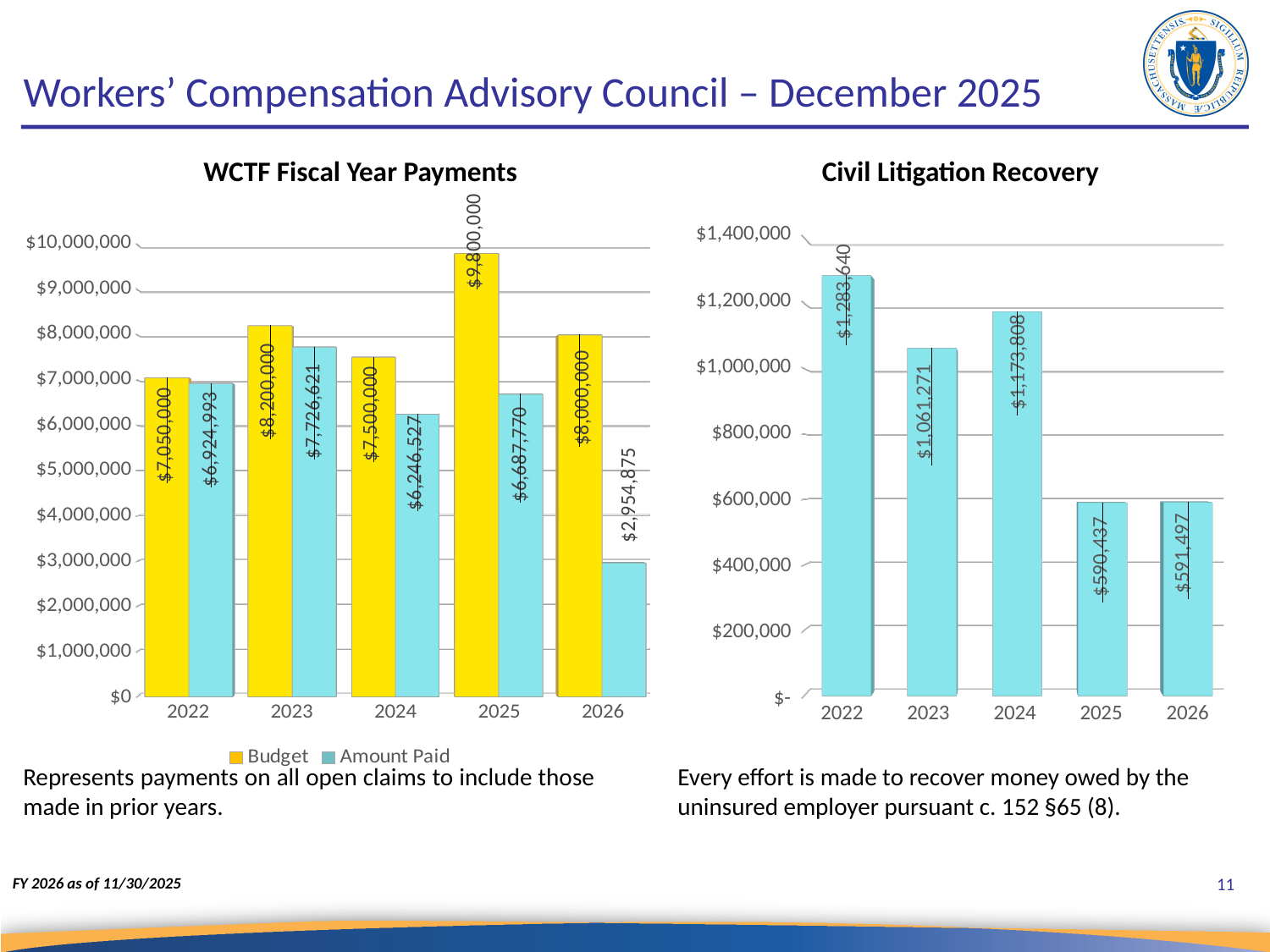
What kind of chart is the Civil Litigation Recovery chart? Bar chart In the WCTF Fiscal Year Payments chart, which year has the lowest Amount Paid? 2026 How many series does the legend of the WCTF Fiscal Year Payments chart list? 2 In the WCTF Fiscal Year Payments chart, which year has the highest Budget? 2025 In the Civil Litigation Recovery chart, which year has the highest value? 2022 In the Civil Litigation Recovery chart, what is the value for 2024? $1,173,808 In the WCTF Fiscal Year Payments chart, what is the difference between the Budget and the Amount Paid for 2025? $3,112,230 In the WCTF Fiscal Year Payments chart, which is larger for 2024: the Budget or the Amount Paid? Budget In the WCTF Fiscal Year Payments chart, what is the Amount Paid for 2026? $2,954,875 In the Civil Litigation Recovery chart, what is the difference between the 2022 and 2023 values? $222,369 In the WCTF Fiscal Year Payments chart, what is the Budget value for 2025? $9,800,000 How many years are shown on the x axis of the Civil Litigation Recovery chart? 5